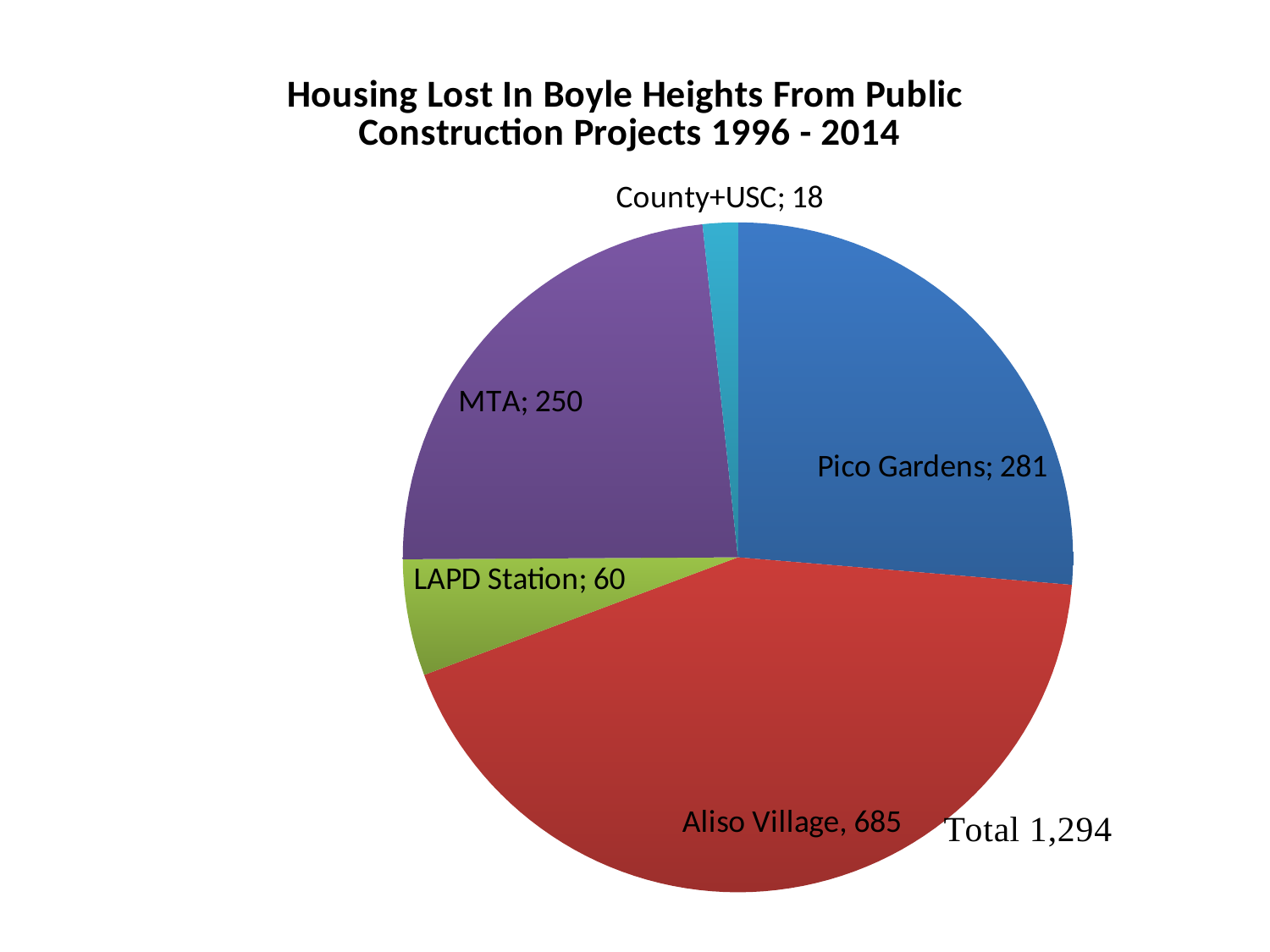
What is the difference between the Aliso Village and Pico Gardens values? 404 Which project accounts for the largest slice of the pie? Aliso Village Which is larger, the value for LAPD Station or the value for County+USC? LAPD Station What total is printed on the slide for all housing lost? 1,294 What is the value for Aliso Village? 685 How many housing units were lost to the MTA project? 250 Which project accounts for the smallest slice of the pie? County+USC What kind of chart is shown on the slide? Pie chart How many slices does the pie chart have? 5 What is the value shown for County+USC? 18 What is the difference between the Pico Gardens and MTA values? 31 What is the title of the chart? Housing Lost In Boyle Heights From Public Construction Projects 1996 - 2014